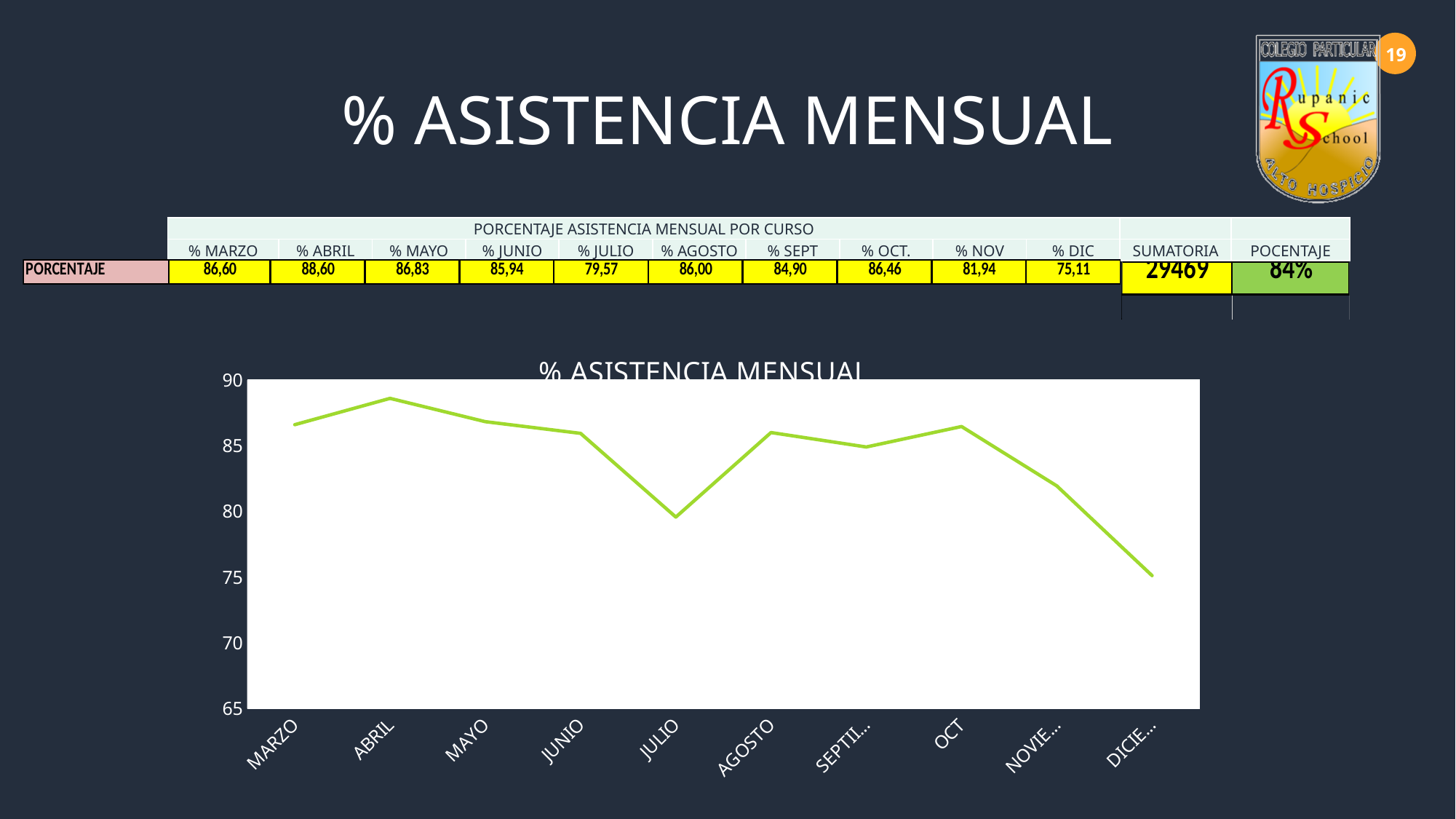
What kind of chart is shown on the slide? line chart Which month has the highest attendance percentage in the chart? ABRIL According to the table on the slide, what is the attendance percentage for % JULIO? 79,57 Is the value for ABRIL greater or less than 85? greater Which is larger, the value for MARZO or the value for JULIO? MARZO Which month has the lowest attendance percentage in the chart? DICIEMBRE What is the title of the chart? % ASISTENCIA MENSUAL Which is larger, the value for OCT or the value for NOVIEMBRE? OCT Is the value for DICIEMBRE greater or less than 80? less Overall, do the values rise or fall from MARZO to DICIEMBRE? fall How many months are plotted on the x axis of the chart? 10 Is the value for JULIO greater or less than 80? less